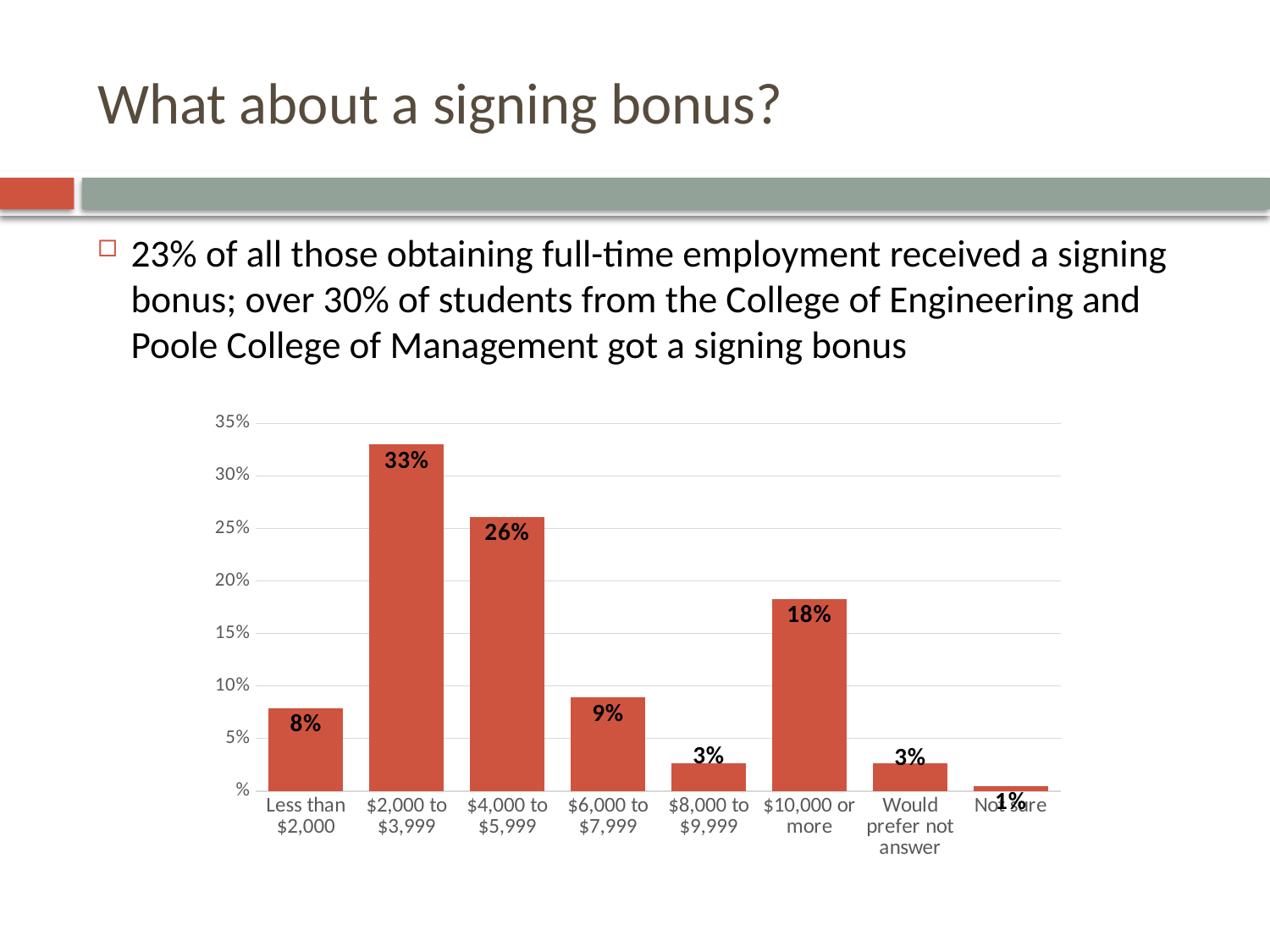
Which category has the highest value? $2,000 to $3,999 What is the value for the "Less than $2,000" category? 8% What is the value for the "Would prefer not answer" category? 3% Which category has the lowest value? Not sure Is the value for "$4,000 to $5,999" greater or less than 25%? greater Which is larger, the value for "$6,000 to $7,999" or the value for "$10,000 or more"? $10,000 or more How many categories are shown on the x axis? 8 What is the difference between the values for "$2,000 to $3,999" and "$4,000 to $5,999"? 7% What is the value for the "$10,000 or more" category? 18% What is the value for the "$2,000 to $3,999" category? 33% What is the highest value shown on the y axis? 35% What kind of chart is shown on the slide? Bar chart